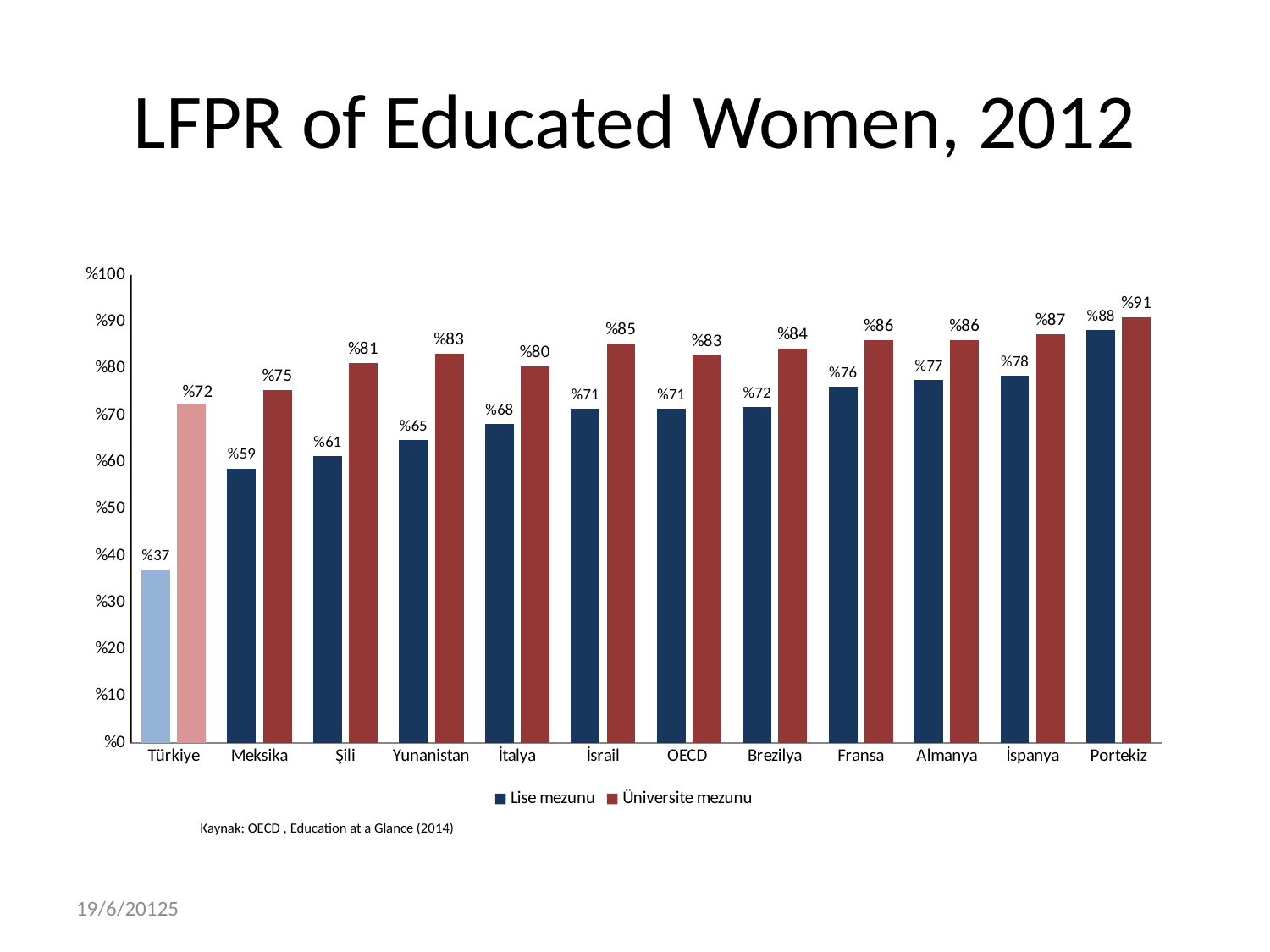
What is the difference between the Üniversite mezunu and Lise mezunu values for Türkiye? %35 Which is larger, the Lise mezunu value for Fransa or the Lise mezunu value for Meksika? Fransa What is the Üniversite mezunu value for Portekiz? %91 Which category has the lowest Lise mezunu value? Türkiye How many series does the legend list? 2 Which category has the highest Üniversite mezunu value? Portekiz What is the title of the chart? LFPR of Educated Women, 2012 Do the Lise mezunu values generally rise or fall from Türkiye to Portekiz? Rise What kind of chart is shown on the slide? Bar chart What is the Üniversite mezunu value for OECD? %83 What is the Lise mezunu value for Türkiye? %37 How many categories are shown on the x axis? 12